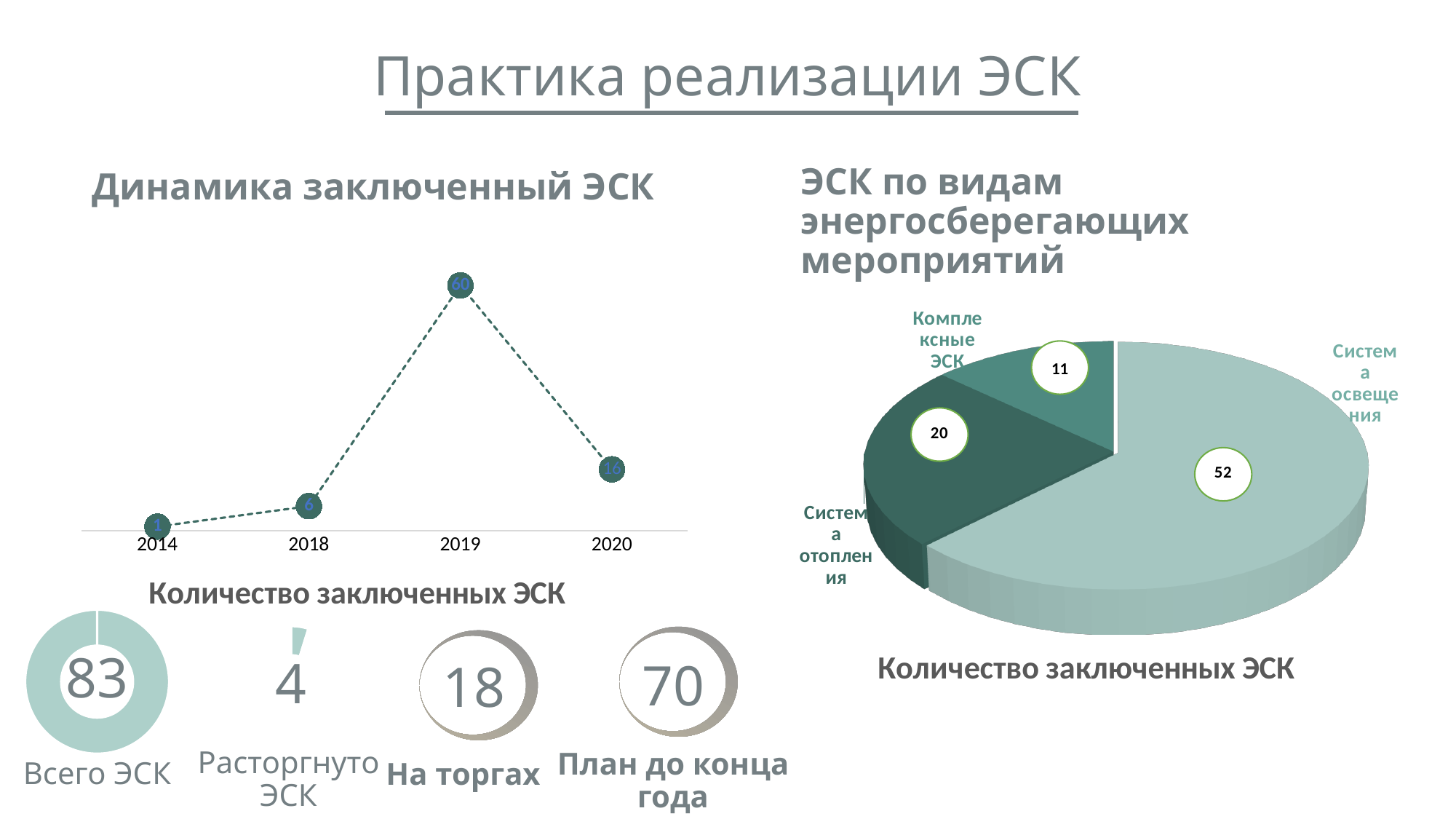
What kind of chart is 'Динамика заключенный ЭСК'? line chart In the pie chart 'ЭСК по видам энергосберегающих мероприятий', how many slices are there? 3 In the chart 'Динамика заключенный ЭСК', do the values rise or fall from 2014 to 2019? rise In the chart 'Динамика заключенный ЭСК', which year has the highest value? 2019 In the pie chart 'ЭСК по видам энергосберегающих мероприятий', what is the value for 'Система освещения'? 52 In the chart 'Динамика заключенный ЭСК', what is the value for 2019? 60 In the chart 'Динамика заключенный ЭСК', how many years are plotted on the x axis? 4 In the pie chart 'ЭСК по видам энергосберегающих мероприятий', which is larger: 'Система отопления' or 'Комплексные ЭСК'? Система отопления In the chart 'Динамика заключенный ЭСК', which year has the lowest value? 2014 In the chart 'Динамика заключенный ЭСК', what is the value for 2020? 16 In the pie chart 'ЭСК по видам энергосберегающих мероприятий', which category has the smallest slice? Комплексные ЭСК In the chart 'Динамика заключенный ЭСК', what is the difference between the values for 2019 and 2020? 44